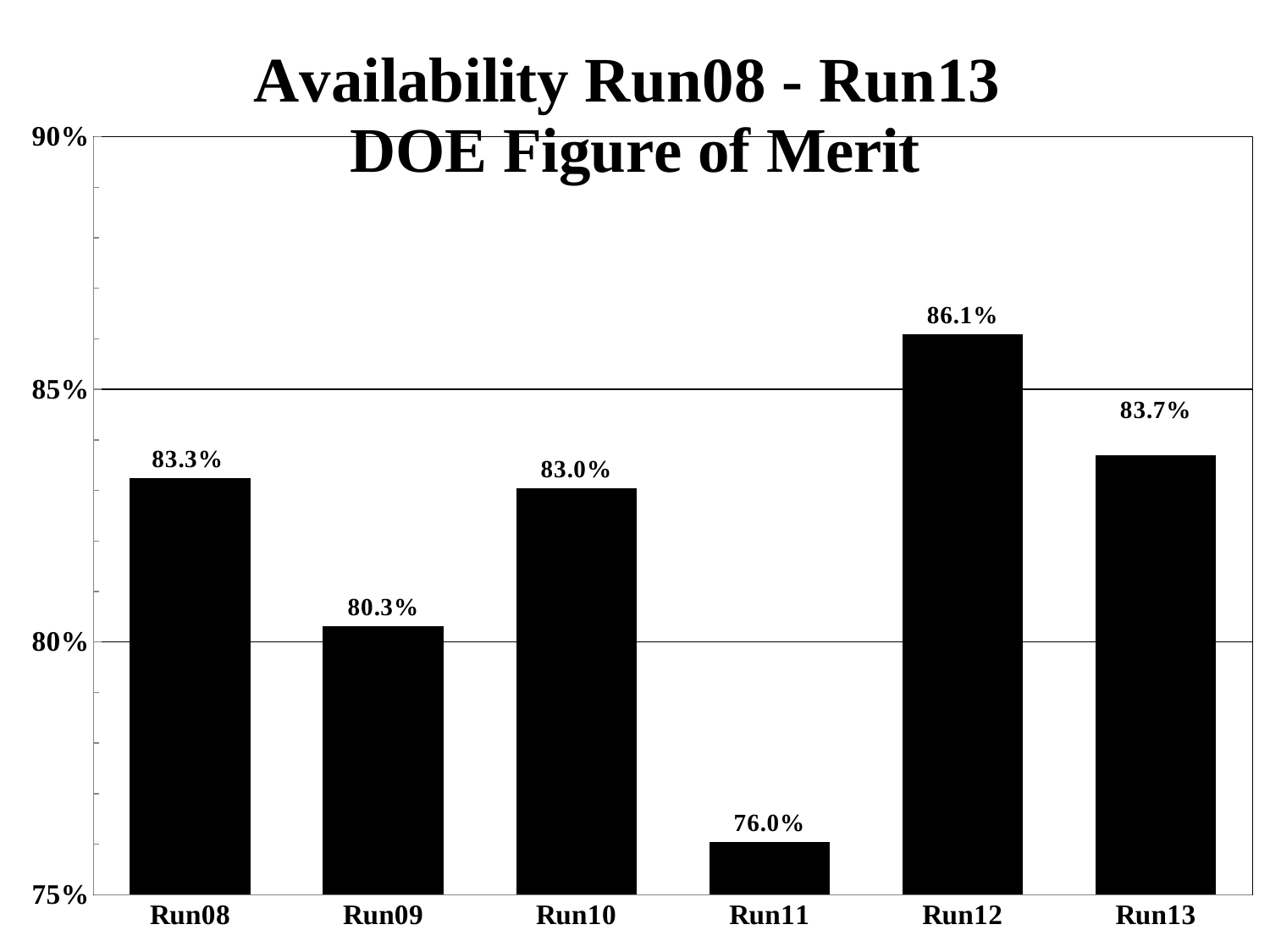
What is the title of the chart? Availability Run08 - Run13 DOE Figure of Merit Which has a higher availability, Run09 or Run10? Run10 Which run has the highest availability? Run12 What is the difference between the availability for Run12 and Run11? 10.1% Which run has the lowest availability? Run11 What is the difference between the availability for Run13 and Run08? 0.4% How many runs are shown on the chart? 6 What is the availability value for Run09? 80.3% Is the value for Run12 greater or less than 85%? greater What is the availability value for Run11? 76.0% What kind of chart is shown on the slide? Bar chart What is the availability value for Run12? 86.1%